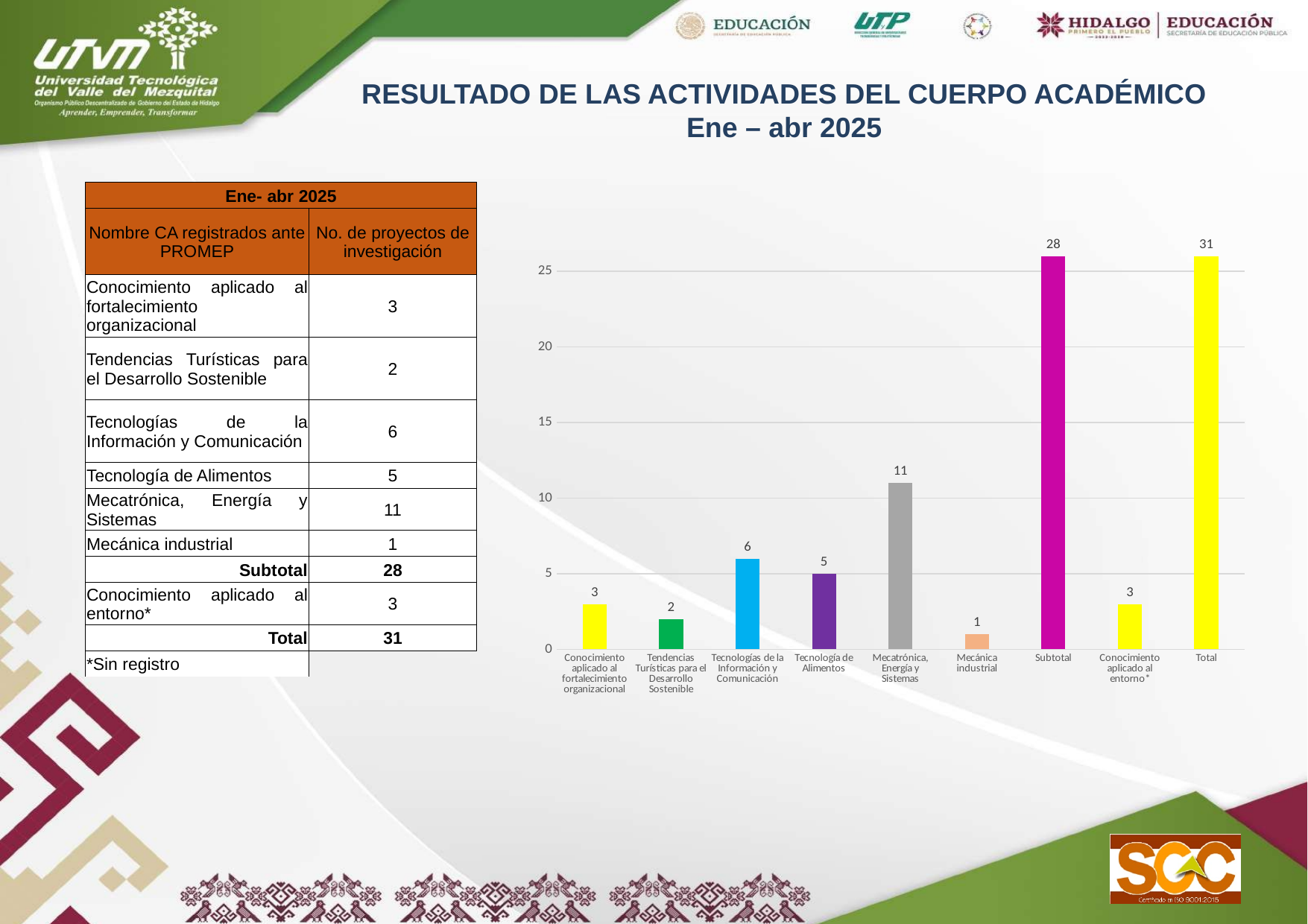
What is the difference between the Total bar and the Subtotal bar? 3 What is the value of the bar for Mecatrónica, Energía y Sistemas? 11 What is the value of the bar for Tecnologías de la Información y Comunicación? 6 What is the value of the bar for Tendencias Turísticas para el Desarrollo Sostenible? 2 How many bars does the chart have? 9 What kind of chart is shown on the slide? bar chart Is the value of the Subtotal bar greater or less than 25? greater Which category has the lowest bar in the chart? Mecánica industrial Excluding the Subtotal and Total bars, which category has the highest bar? Mecatrónica, Energía y Sistemas What colour is the Subtotal bar? magenta Which is larger, the bar for Tecnología de Alimentos or the bar for Tecnologías de la Información y Comunicación? Tecnologías de la Información y Comunicación What is the value of the Total bar? 31